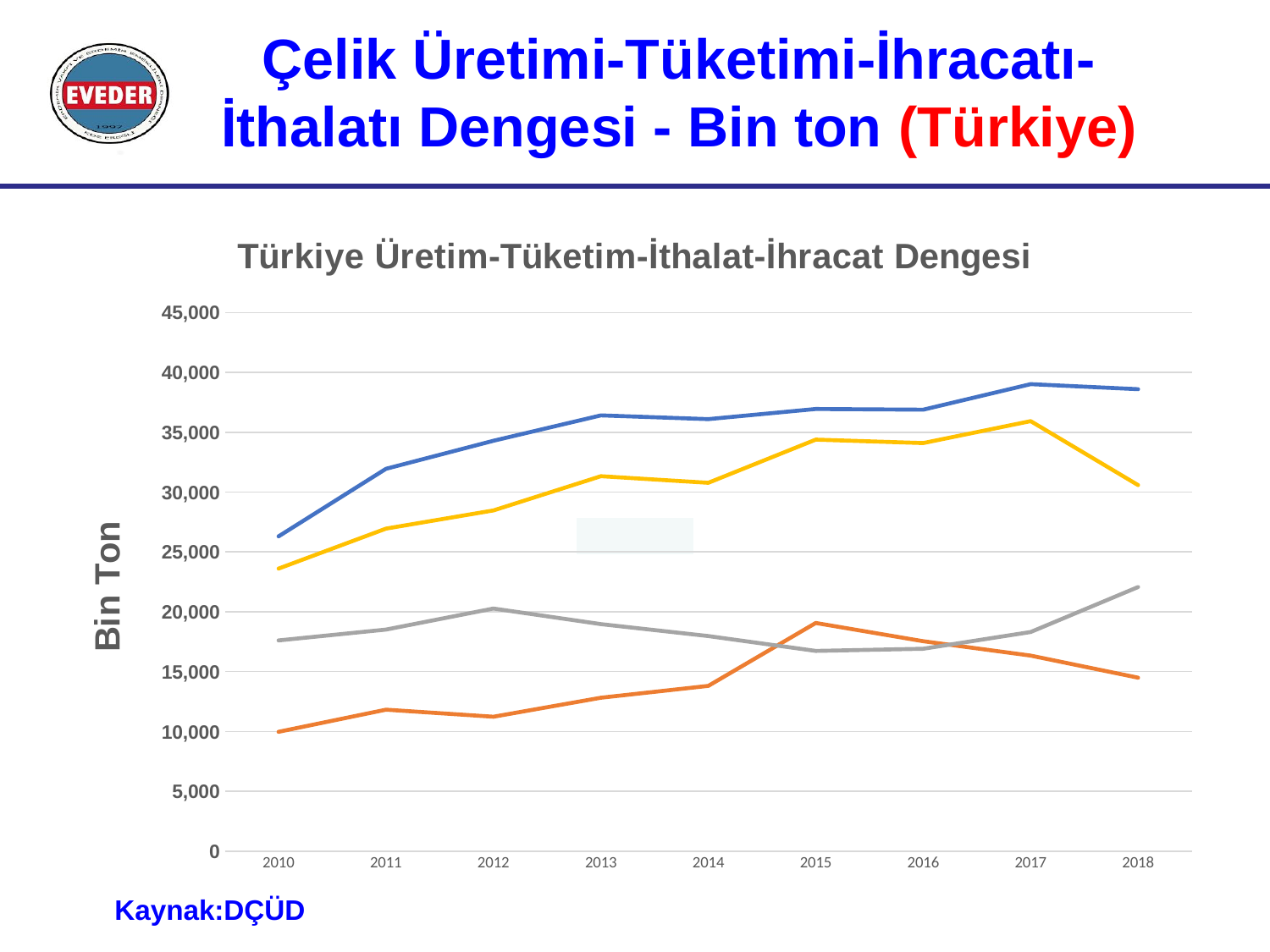
What is the label on the vertical axis of the chart? Bin Ton How many years are shown along the x axis of the chart? 9 Is the value of the gray line in 2018 greater or less than 20,000? greater In which year does the orange line reach its highest value? 2015 Is the value of the orange line in 2015 greater or less than 15,000? greater Is the value of the blue line in 2010 greater or less than 25,000? greater How many lines are plotted on the chart? 4 In which year does the blue line reach its highest value? 2017 What is the title of the chart? Türkiye Üretim-Tüketim-İthalat-İhracat Dengesi What kind of chart is shown on the slide? line chart Does the orange line rise or fall between 2015 and 2018? fall